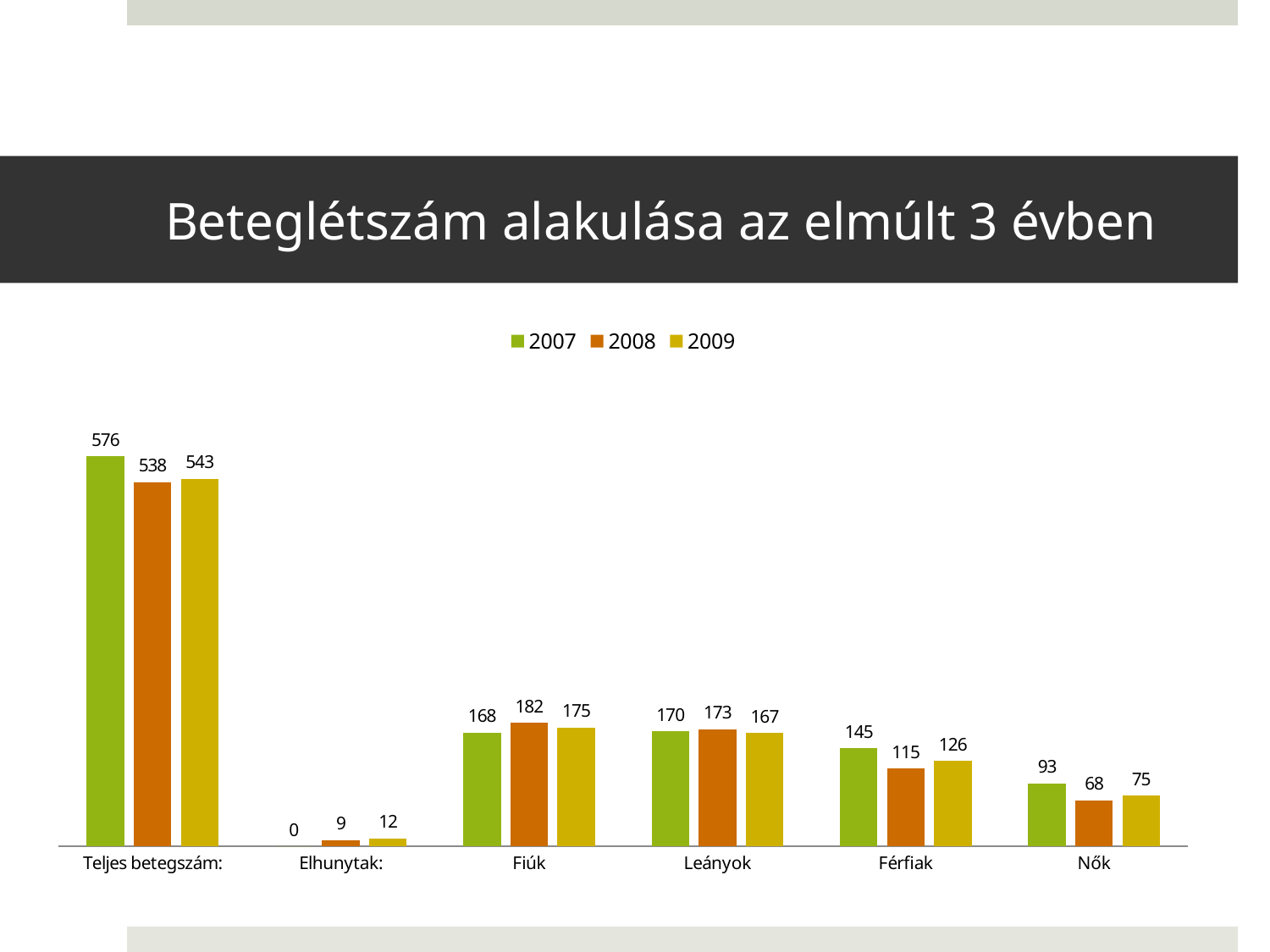
How many series does the legend list? 3 What is the value for Nők in 2008? 68 What is the value for Teljes betegszám in 2007? 576 Which category has the lowest value in the 2007 series? Elhunytak What kind of chart is shown on the slide? Bar chart What is the difference between the 2007 and 2008 values for Férfiak? 30 Do the values for Leányok rise or fall from 2008 to 2009? Fall What is the value for Elhunytak in 2009? 12 How many categories are shown on the x axis? 6 What is the title of the chart? Beteglétszám alakulása az elmúlt 3 évben Which is larger for Fiúk: the 2008 value or the 2009 value? 2008 Which category has the highest value in the 2009 series? Teljes betegszám